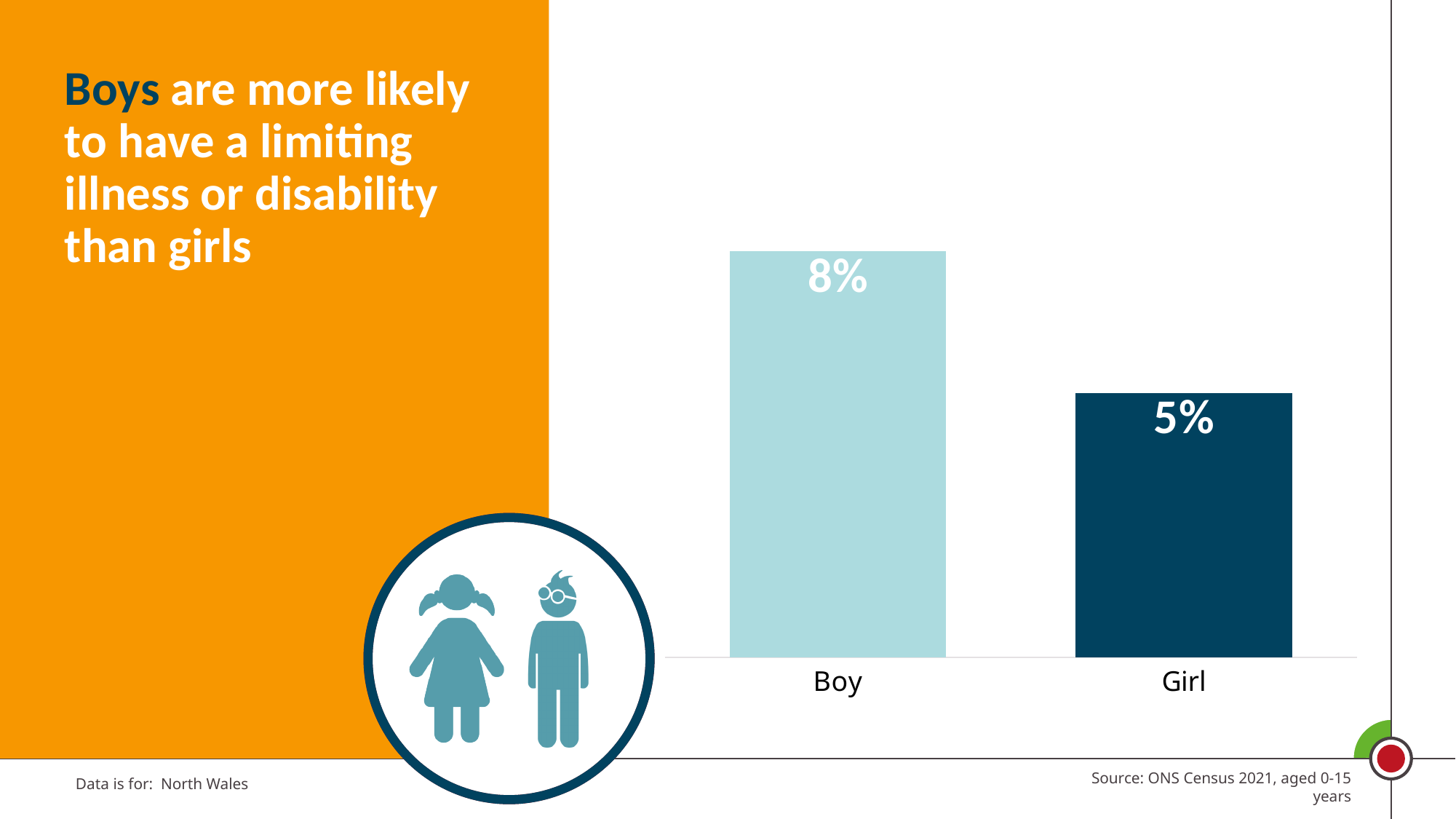
What is the value for Boy? 8% Which area does the data on the slide cover? North Wales Do the values rise or fall from Boy to Girl along the x axis? Fall Which is larger, the value for Boy or the value for Girl? Boy What is the difference between the values for Boy and Girl? 3% Which category has the highest value? Boy What kind of chart is shown on the slide? Bar chart How many categories are shown in the chart? 2 Which category has the lowest value? Girl What colour is the bar for Girl? Dark blue What is the value for Girl? 5%